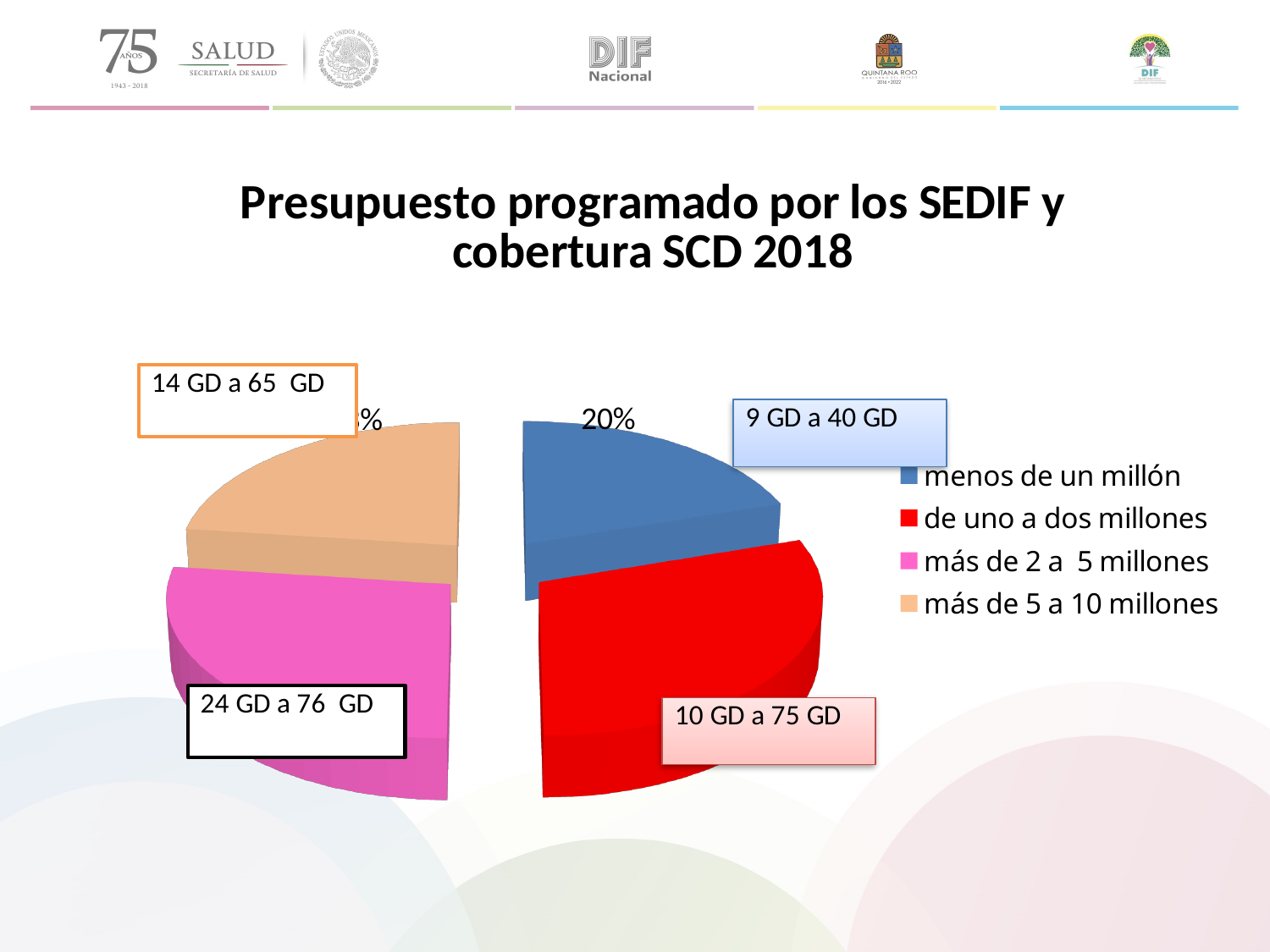
Which colour represents 'de uno a dos millones' in the pie chart? red What text box label is placed next to the 'menos de un millón' slice? 9 GD a 40 GD What text box label is placed next to the 'de uno a dos millones' slice? 10 GD a 75 GD What text box label is placed next to the 'más de 2 a 5 millones' slice? 24 GD a 76 GD What share of the pie does the 'menos de un millón' category represent? 20% How many slices does the pie chart have? 4 What percentage is shown for the 'menos de un millón' slice? 20% How many entries does the legend list? 4 Which slice is larger: 'de uno a dos millones' or 'menos de un millón'? de uno a dos millones Which slice is larger: 'más de 2 a 5 millones' or 'menos de un millón'? más de 2 a 5 millones What is the title of the chart on the slide? Presupuesto programado por los SEDIF y cobertura SCD 2018 What type of chart is shown on the slide? pie chart